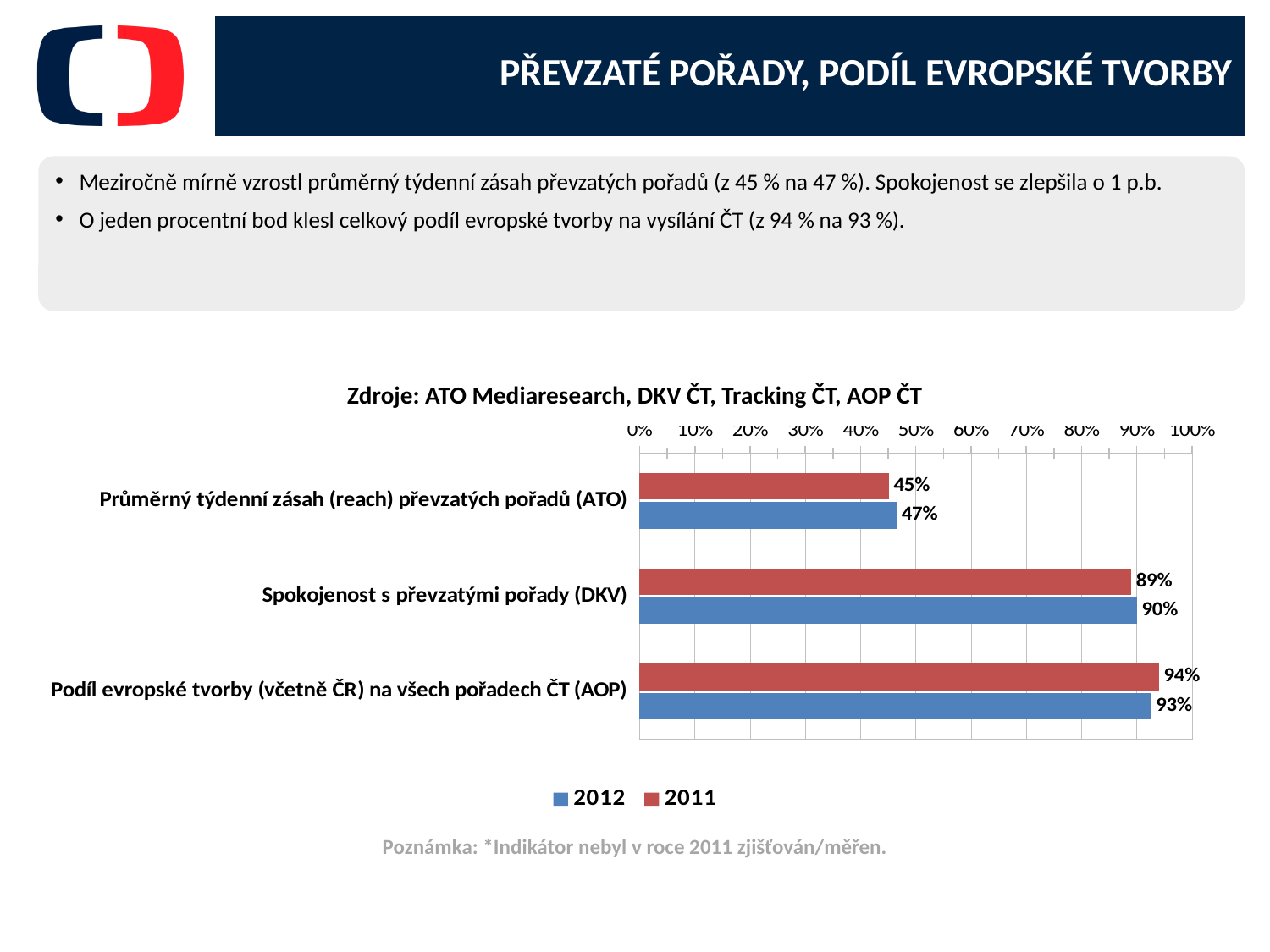
What is the 2011 value for Spokojenost s převzatými pořady (DKV)? 89% How many series does the legend list? 2 How many categories are shown on the chart? 3 What is the 2012 value for Průměrný týdenní zásah (reach) převzatých pořadů (ATO)? 47% What is the 2012 value for Podíl evropské tvorby (včetně ČR) na všech pořadech ČT (AOP)? 93% What is the 2011 value for Podíl evropské tvorby (včetně ČR) na všech pořadech ČT (AOP)? 94% Which category has the highest 2011 value? Podíl evropské tvorby (včetně ČR) na všech pořadech ČT (AOP) For Spokojenost s převzatými pořady (DKV), which year has the larger value, 2012 or 2011? 2012 What is the difference between the 2011 and 2012 values for Podíl evropské tvorby (včetně ČR) na všech pořadech ČT (AOP)? 1% Which category has the lowest 2012 value? Průměrný týdenní zásah (reach) převzatých pořadů (ATO) What is the difference between the 2012 and 2011 values for Průměrný týdenní zásah (reach) převzatých pořadů (ATO)? 2% What kind of chart is shown on the slide? Bar chart